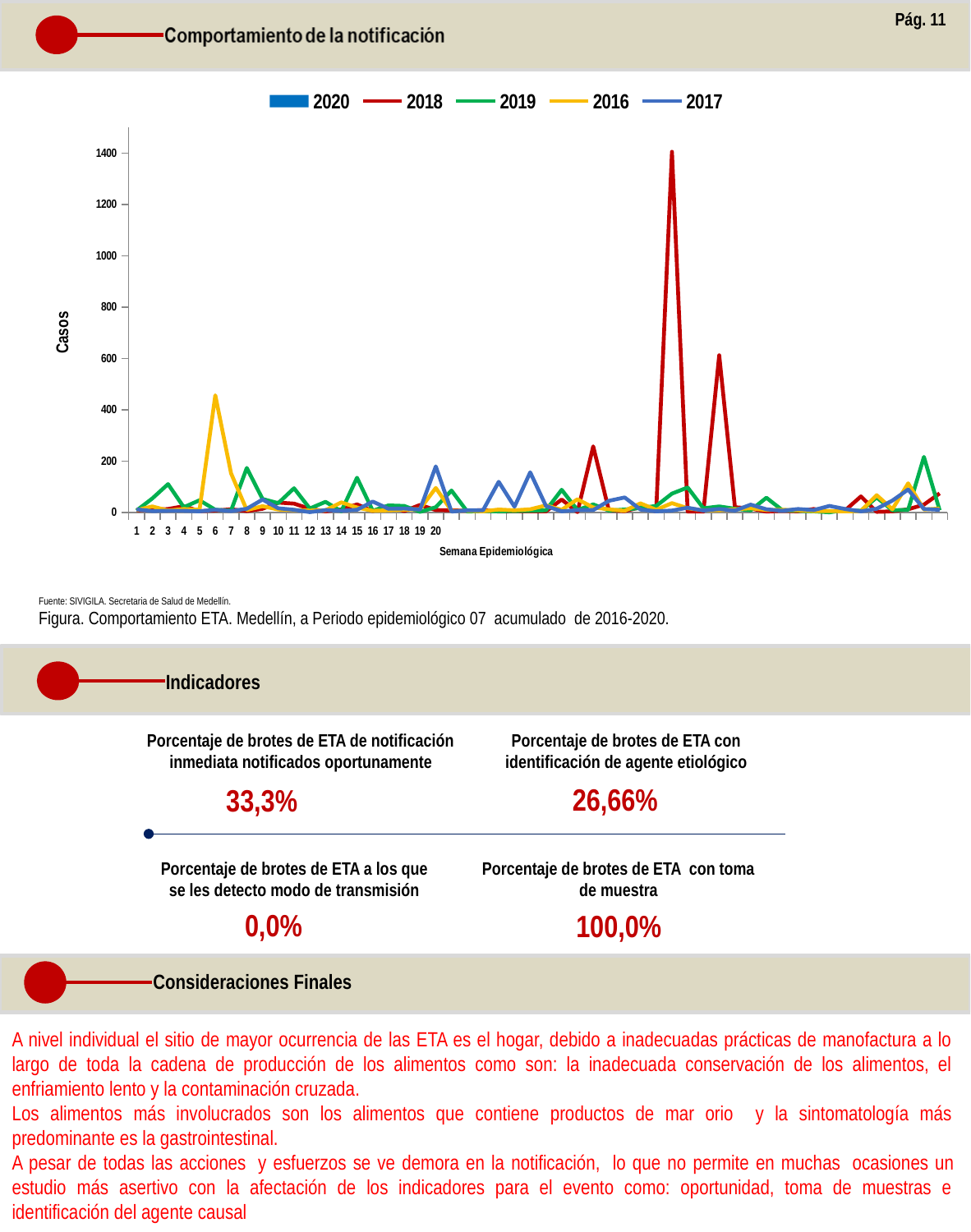
What is the label of the vertical axis of the chart? Casos Which series reaches the highest value on the chart? 2018 What kind of chart is used to show the cases by epidemiological week? line chart Is the peak of the 2016 series at week 6 greater or less than 600? less Is the second peak of the 2018 series (after its highest peak) greater or less than 400? greater Is the highest peak of the 2018 series greater or less than 1200? greater Which year is shown in yellow in the chart legend? 2016 How many series does the legend of the line chart list? 5 Which is higher, the peak of the 2016 series or the peak of the 2019 series? 2016